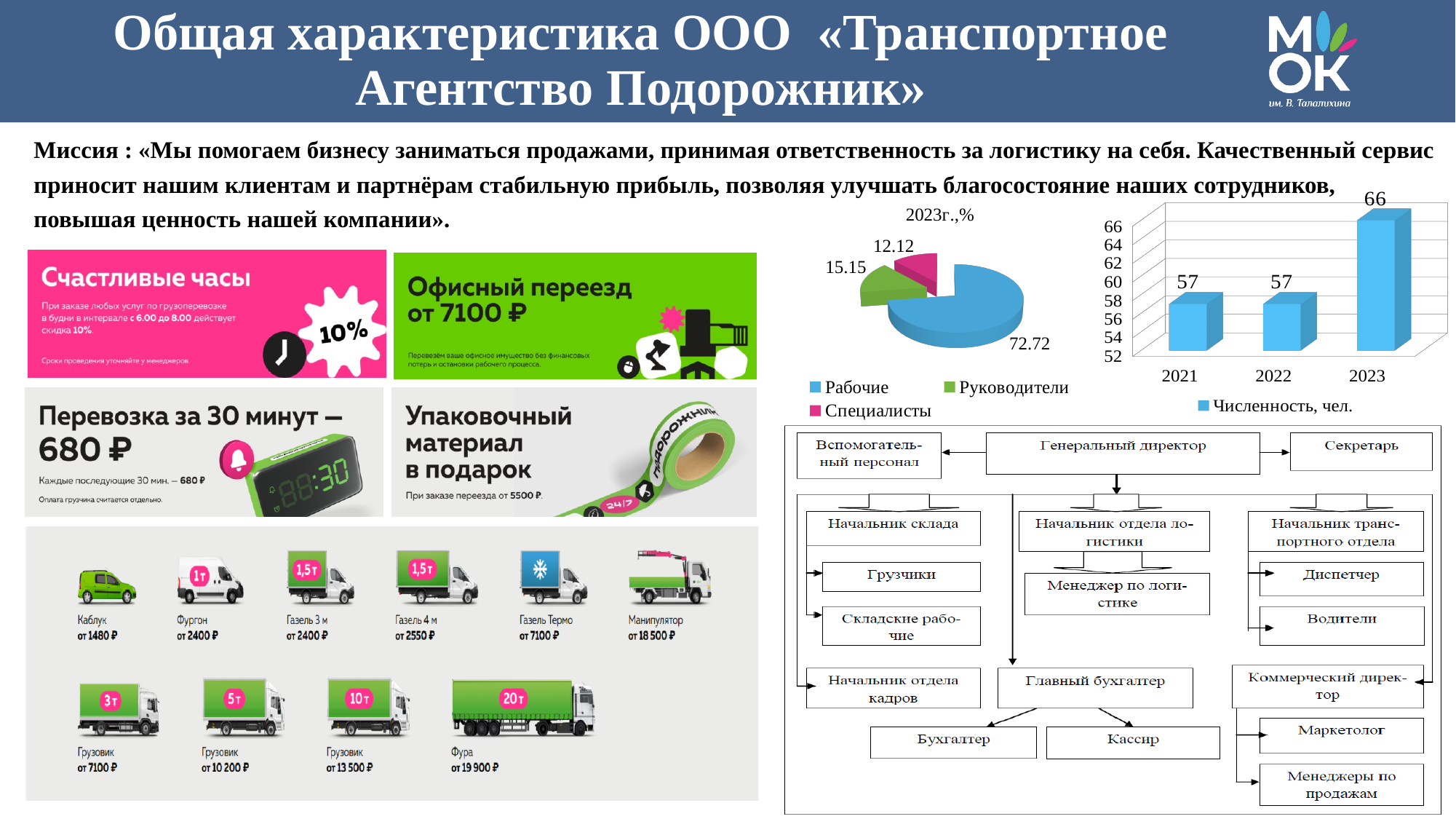
In the bar chart on the right (Численность, чел.), what is the value for 2023? 66 In the pie chart titled "2023г.,%", which category has the smallest slice? Специалисты In the pie chart titled "2023г.,%", what is the value for Руководители? 15.15 What kind of chart is the chart on the right showing Численность, чел.? bar chart In the pie chart titled "2023г.,%", what is the difference between the values for Руководители and Специалисты? 3.03 In the bar chart on the right (Численность, чел.), what is the difference between the values for 2023 and 2022? 9 In the bar chart on the right (Численность, чел.), which year has the highest value? 2023 In the pie chart titled "2023г.,%", what is the value for Рабочие? 72.72 In the bar chart on the right (Численность, чел.), what is the value for 2021? 57 In the pie chart titled "2023г.,%", which category has the largest slice? Рабочие In the pie chart titled "2023г.,%", how many categories does the legend list? 3 In the pie chart titled "2023г.,%", what is the value for Специалисты? 12.12